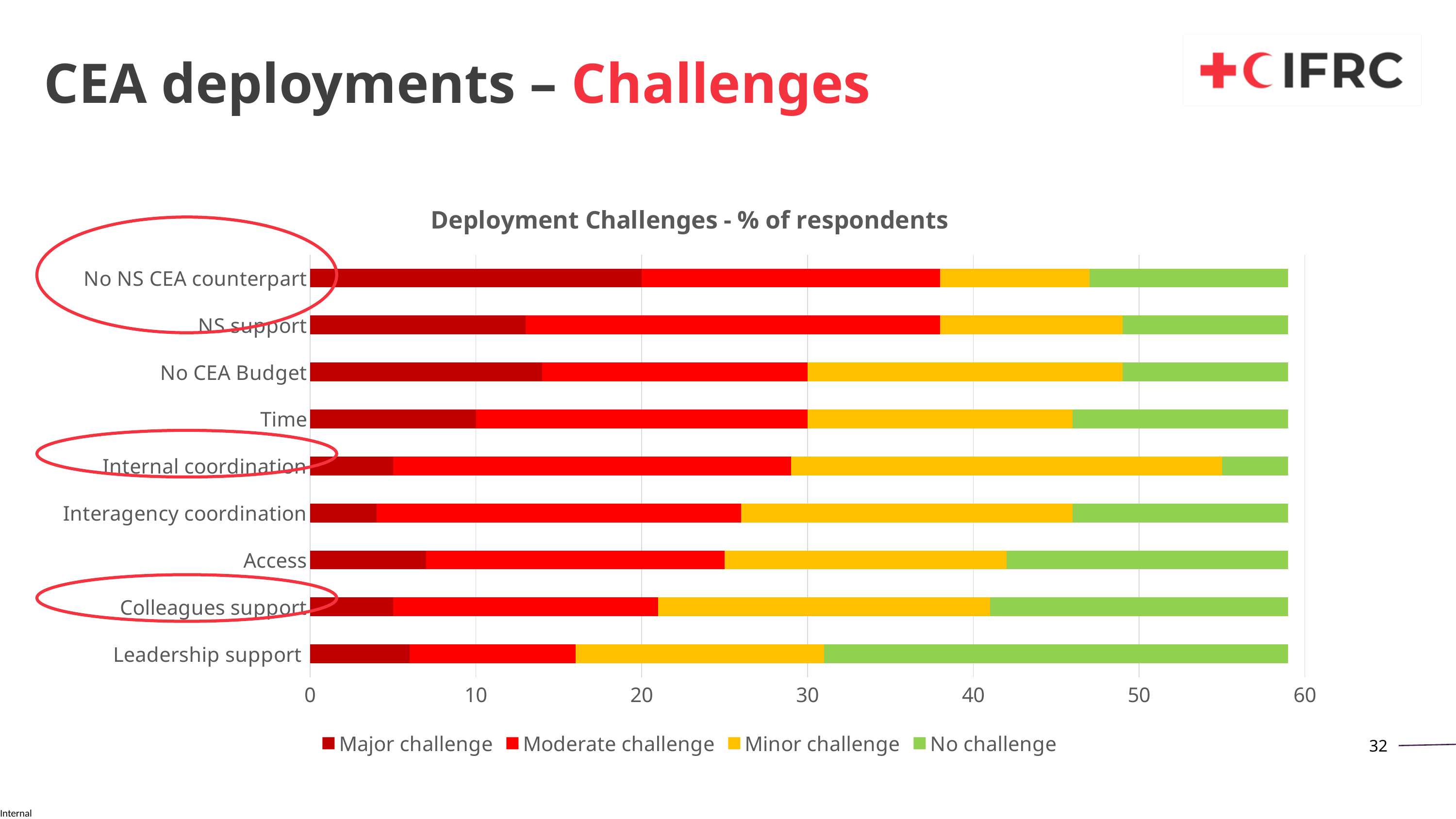
Which category has the smallest 'No challenge' segment? Internal coordination How many series does the chart legend list? 4 What kind of chart is shown on the slide? Stacked bar chart Is the 'Major challenge' value for No NS CEA counterpart greater or less than 10? greater Which has a larger 'Major challenge' segment, No NS CEA counterpart or NS support? No NS CEA counterpart Which category has the largest 'Major challenge' segment? No NS CEA counterpart Which has a larger 'No challenge' segment, Leadership support or Access? Leadership support Which category has the largest 'No challenge' segment? Leadership support What is the title of the chart? Deployment Challenges - % of respondents How many challenge categories are listed on the chart? 9 Is the 'Major challenge' value for Colleagues support greater or less than 10? less Which colour represents 'No challenge' in the chart legend? Green